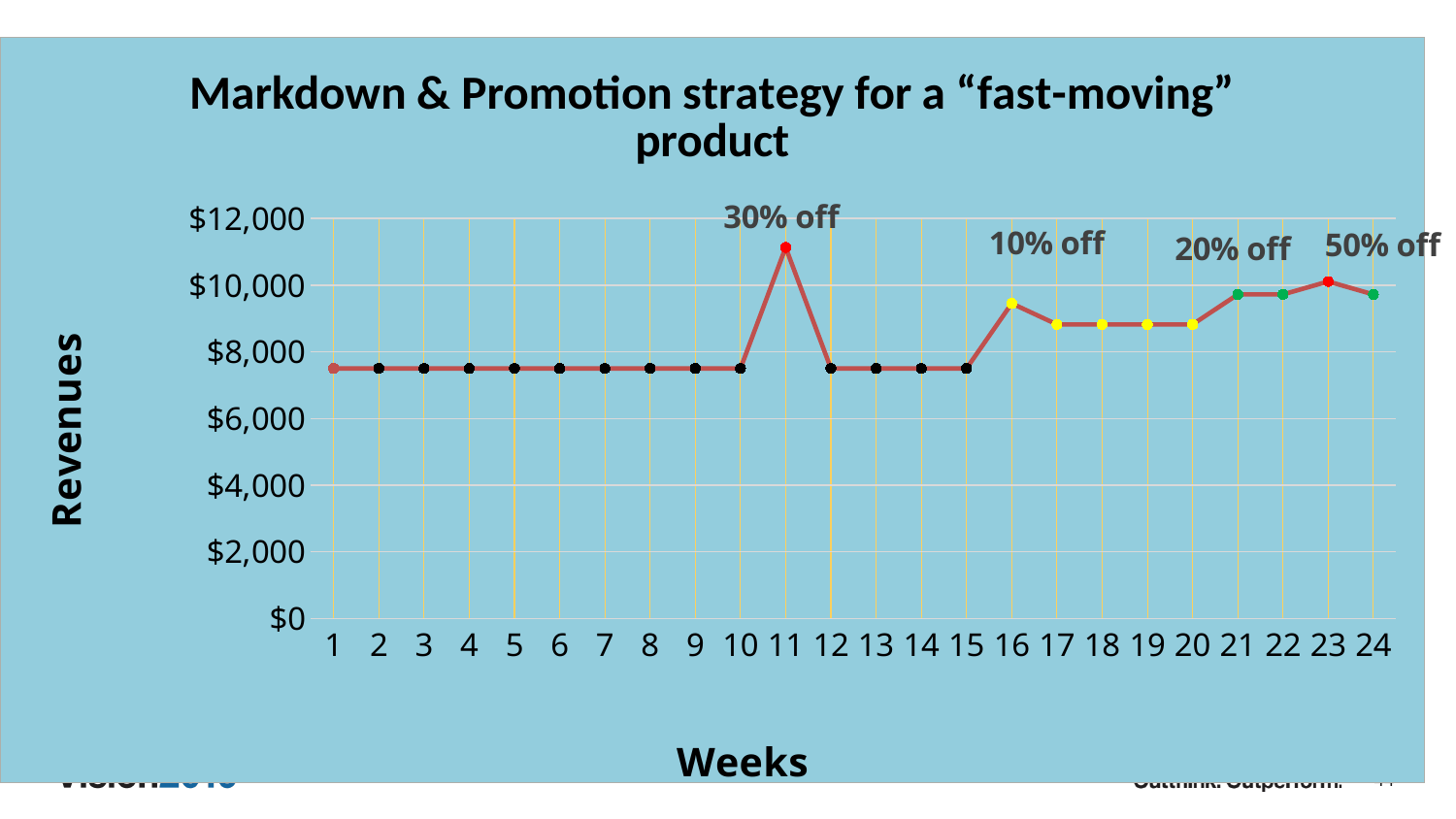
Which week has the larger revenue, week 16 or week 17? 16 What kind of chart is shown on the slide? line chart What promotion label is shown above the peak at week 11? 30% off Is the revenue for week 18 greater or less than $10,000? less Does revenue rise or fall from week 15 to week 16? rise How many weeks are plotted on the x axis? 24 What is the label of the y axis? Revenues Which week has the larger revenue, week 11 or week 16? 11 Is the revenue for week 16 greater or less than $8,000? greater Is the revenue for week 5 greater or less than $8,000? less Which week has the highest revenue? 11